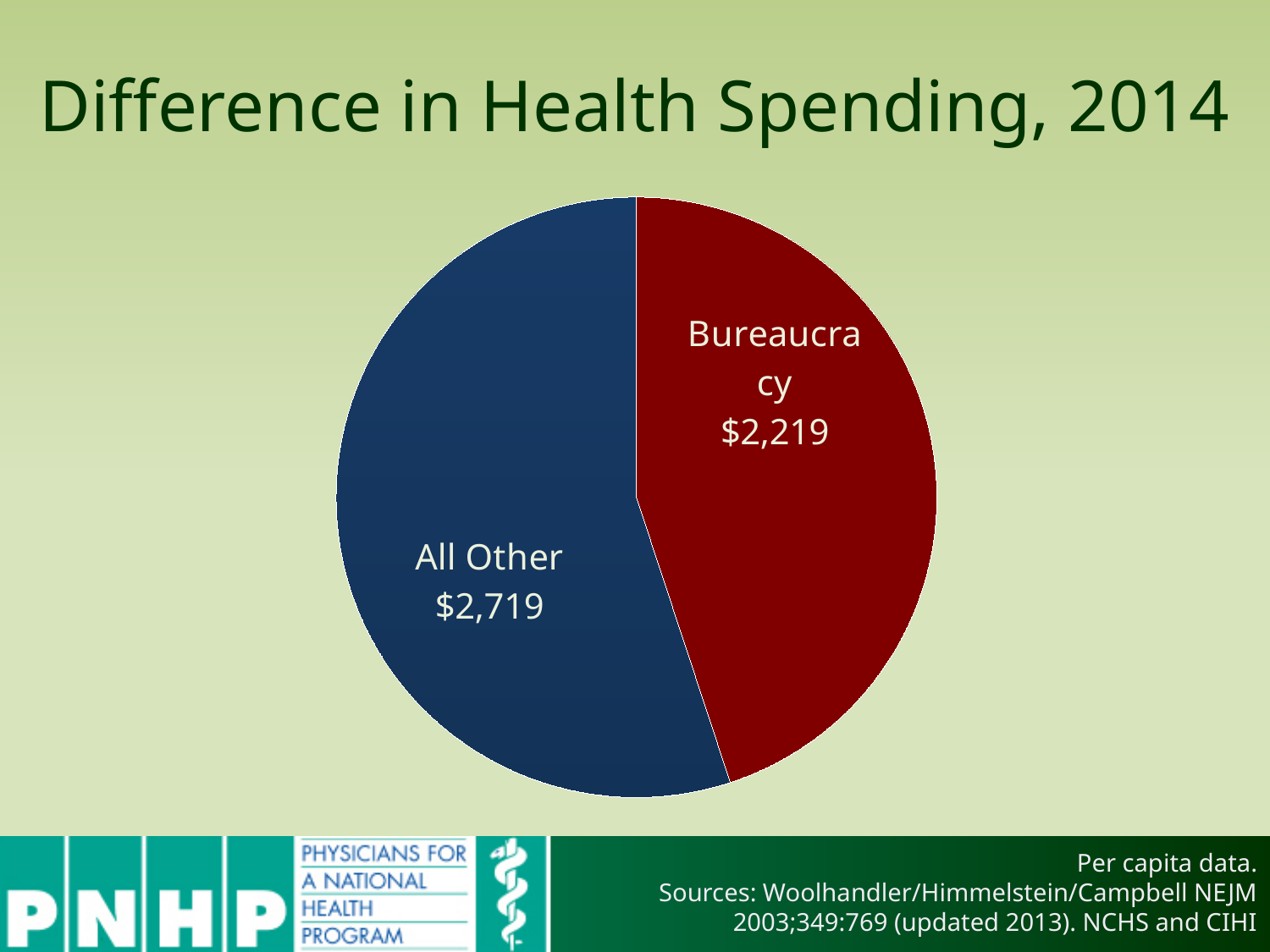
What is the difference between the All Other and Bureaucracy values? $500 What is the total of the two slices in the pie chart? $4,938 What is the value of the Bureaucracy slice? $2,219 Which is larger, Bureaucracy or All Other? All Other Which slice is the smallest? Bureaucracy How many slices does the pie chart have? 2 Which slice is the largest? All Other What is the value of the All Other slice? $2,719 What share of the pie does the Bureaucracy slice represent? 44.9% What is the title of the slide? Difference in Health Spending, 2014 What kind of chart is shown on the slide? Pie chart What colour is the Bureaucracy slice? Red